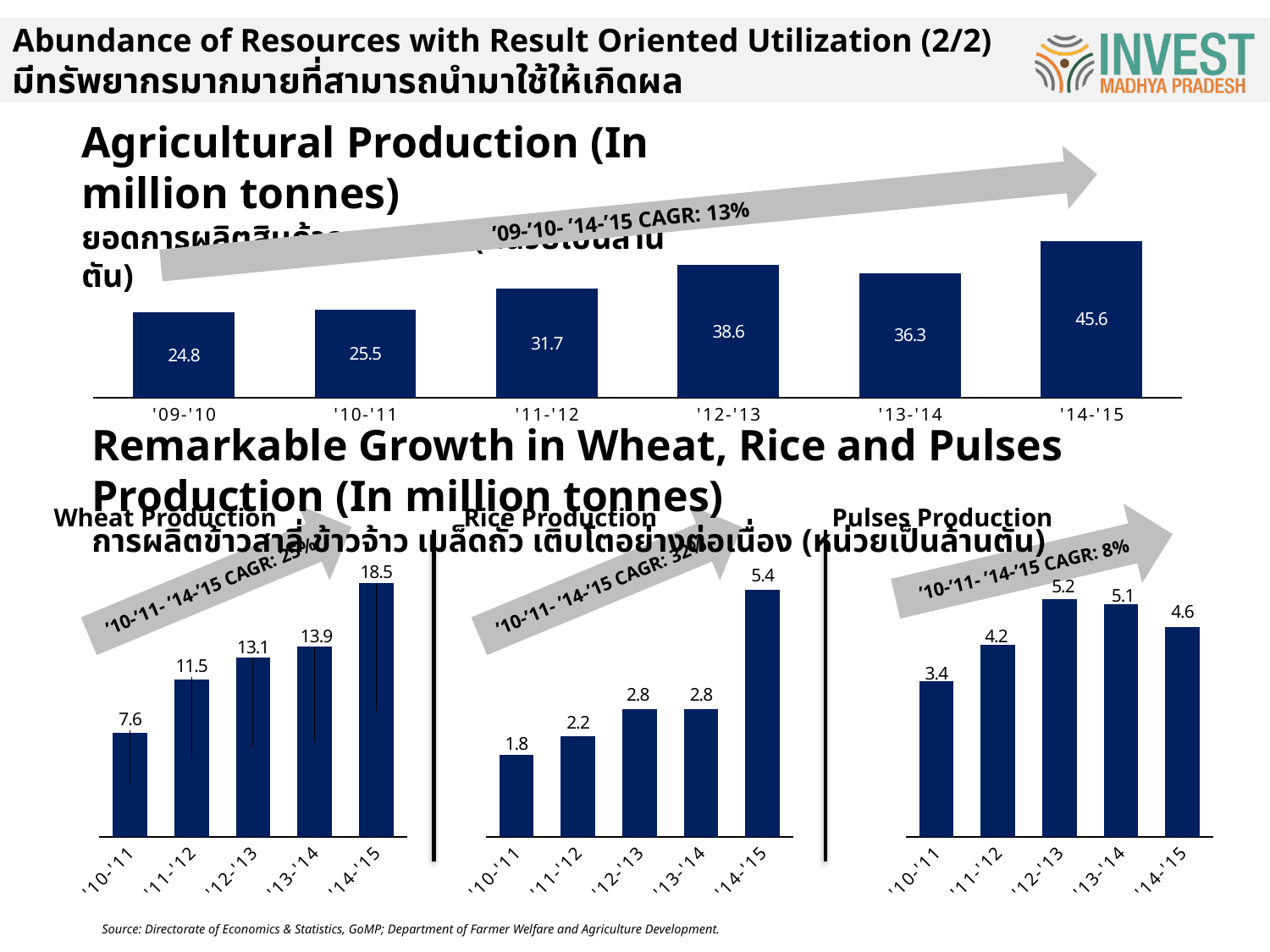
In the Wheat Production chart, what is the difference between '14-'15 and '10-'11? 10.9 In the Wheat Production chart, which year has the highest value? '14-'15 In the Agricultural Production chart, which year has the lowest value? '09-'10 What type of chart is the Pulses Production chart? Bar chart In the Pulses Production chart, which year has the lowest value? '10-'11 In the Rice Production chart, what is the value for '13-'14? 2.8 In the Rice Production chart, which is larger, '14-'15 or '12-'13? '14-'15 In the Wheat Production chart, what is the value for '11-'12? 11.5 In the Agricultural Production chart, what is the value for '14-'15? 45.6 In the Agricultural Production chart, how many bars are plotted? 6 In the Agricultural Production chart, what is the difference between '12-'13 and '13-'14? 2.3 In the Pulses Production chart, what is the value for '12-'13? 5.2